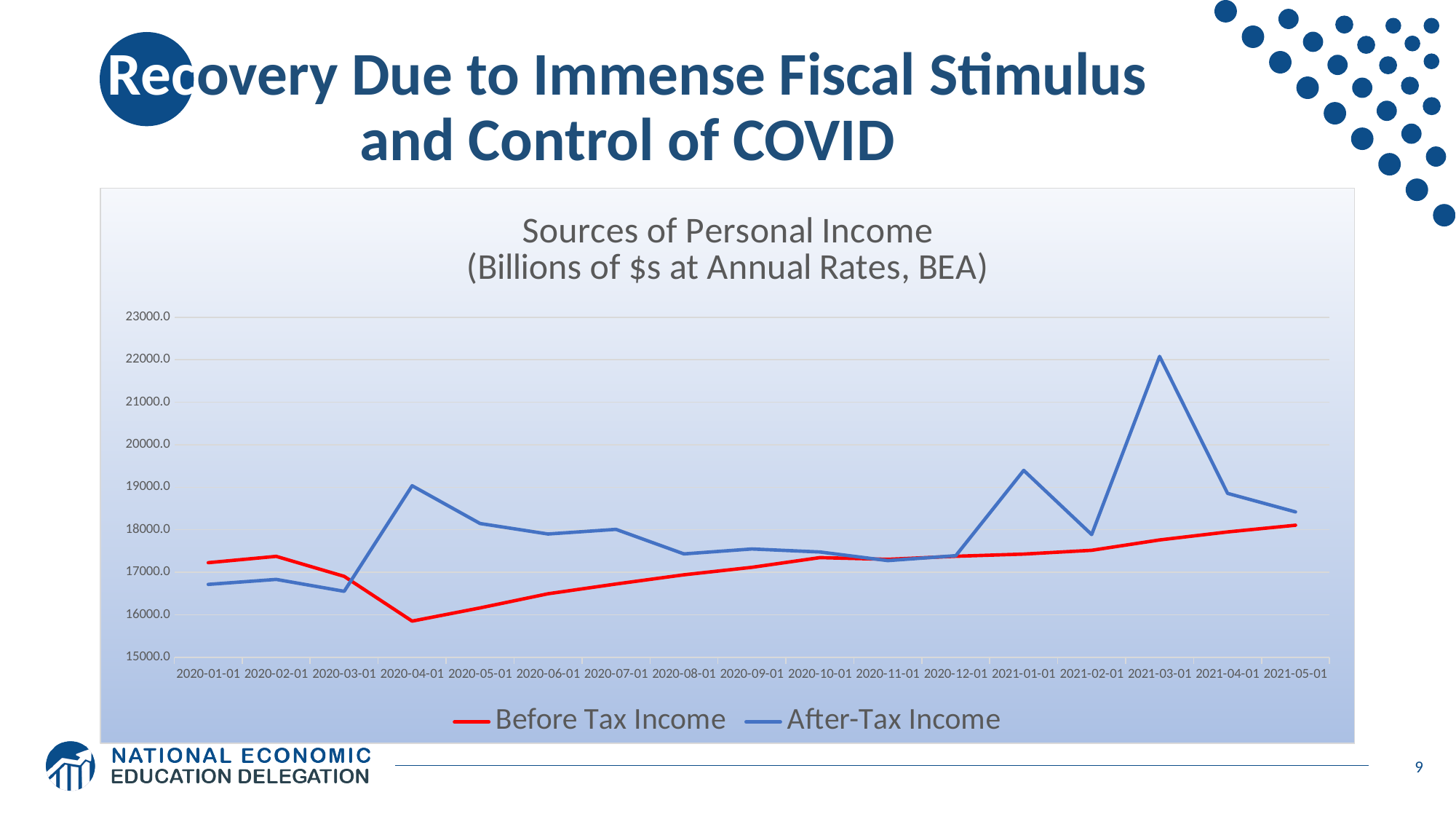
How many dates are shown along the x axis? 17 Is the value for Before Tax Income on 2021-05-01 greater or less than 17000.0? greater On which date does After-Tax Income reach its highest value? 2021-03-01 Is the value for After-Tax Income on 2021-01-01 greater or less than 19000.0? greater On which date does Before Tax Income reach its lowest value? 2020-04-01 On 2020-01-01, which series has the higher value, Before Tax Income or After-Tax Income? Before Tax Income What kind of chart is shown on the slide? line chart Is the value for After-Tax Income on 2021-03-01 greater or less than 21000.0? greater On 2021-03-01, which series has the higher value, Before Tax Income or After-Tax Income? After-Tax Income Does Before Tax Income rise or fall from 2020-04-01 to 2021-05-01? rise How many series does the legend list? 2